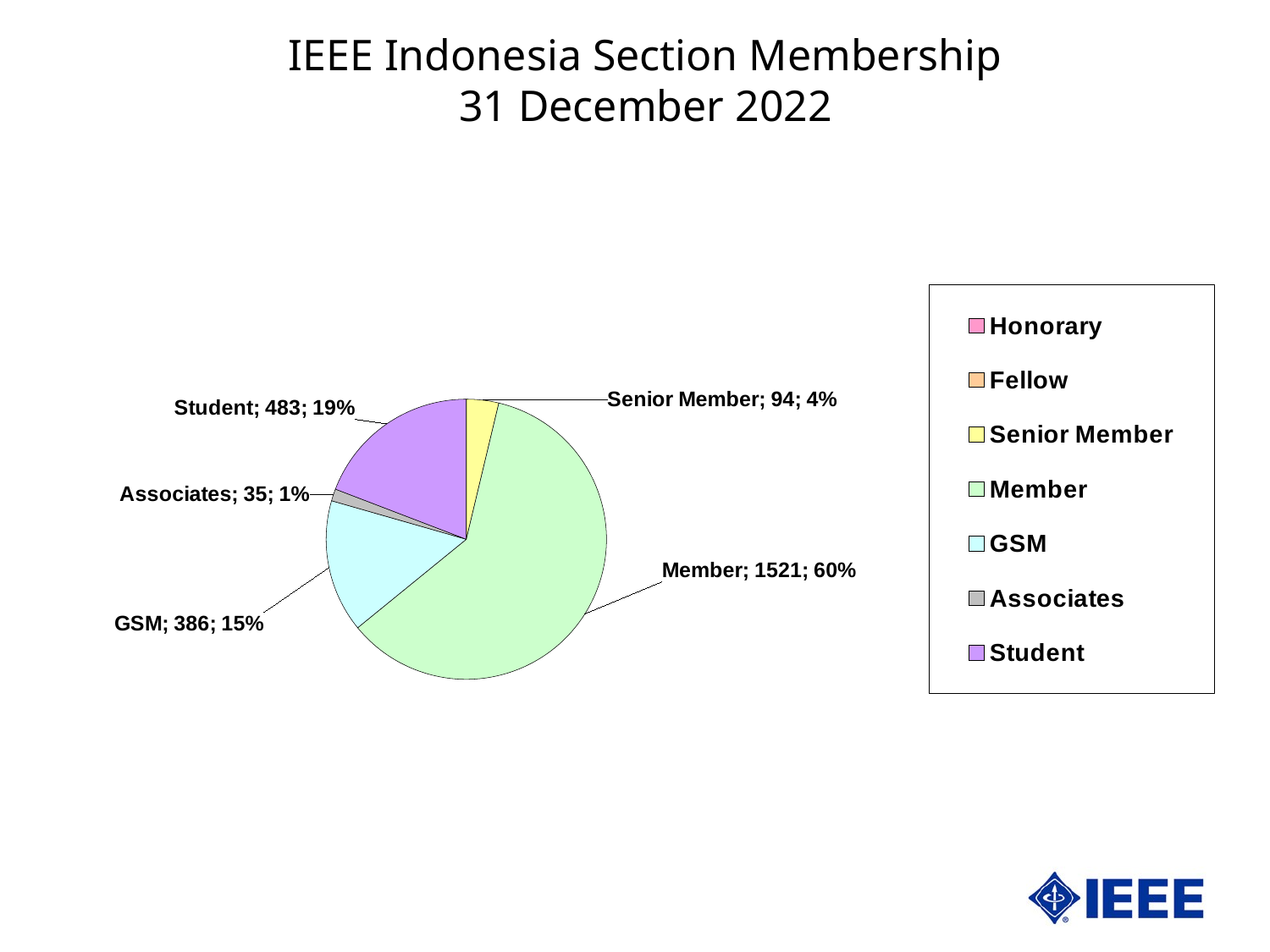
What kind of chart is shown on the slide? pie chart Which labelled category has the smallest slice? Associates What is the title of the chart? IEEE Indonesia Section Membership 31 December 2022 What percentage share does the Student category have? 19% How many entries does the legend list? 7 How many members are in the GSM category? 386 Which is larger, the Senior Member slice or the GSM slice? GSM What percentage share does Senior Member have? 4% How many members are in the Member category? 1521 What is the difference between the Student and GSM counts? 97 Which labelled category has the largest slice? Member What is the value for Associates? 35